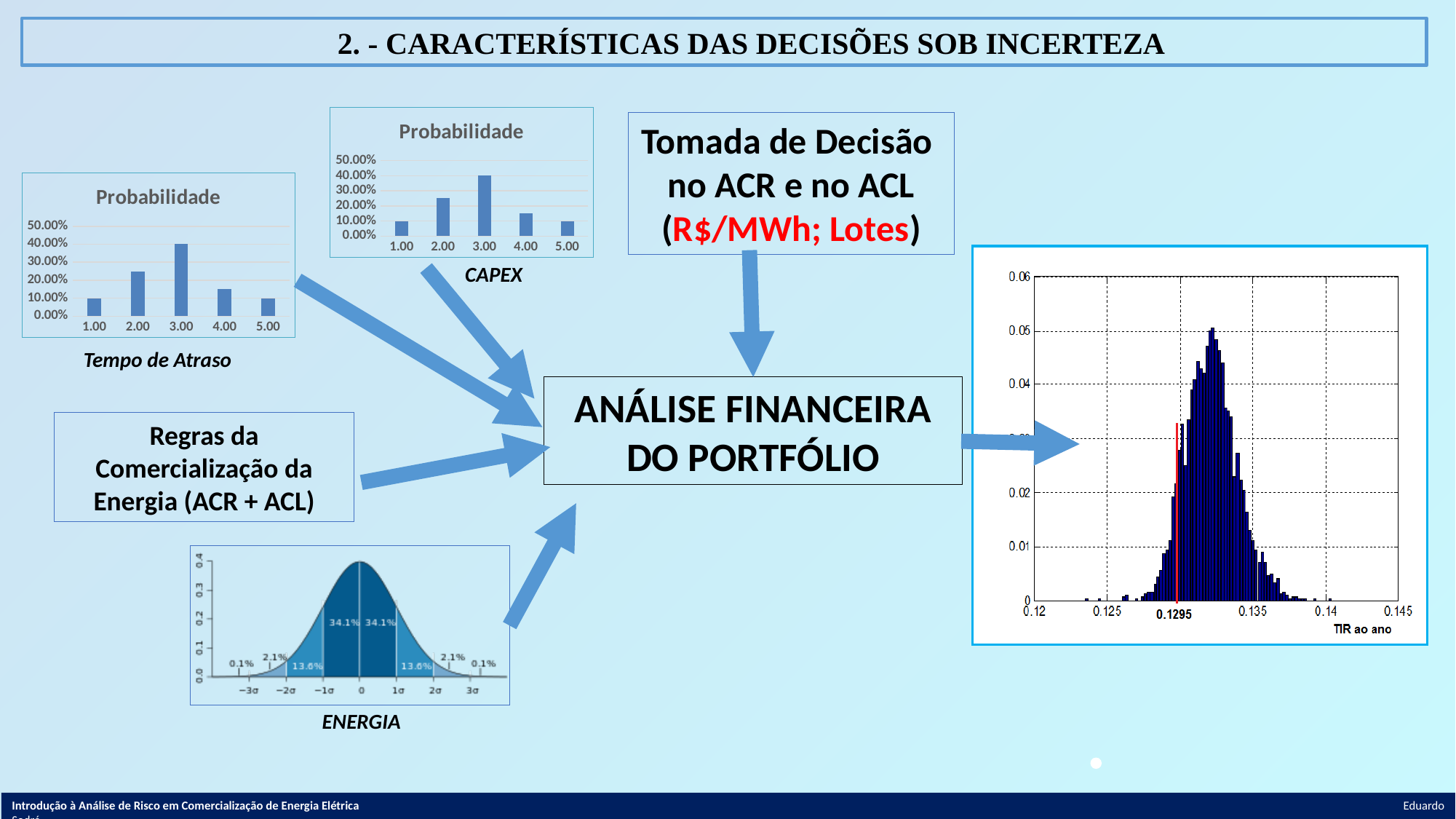
In the ENERGIA normal distribution chart, what percentage is labelled between 1σ and 2σ? 13.6% In the CAPEX Probabilidade chart, which is larger, the value for 2.00 or the value for 4.00? 2.00 In the 'Tempo de Atraso' Probabilidade chart, which category has the highest probability? 3.00 What kind of chart is the 'Tempo de Atraso' Probabilidade chart? bar chart In the CAPEX Probabilidade chart, which category has the highest probability? 3.00 In the CAPEX Probabilidade chart, is the value for 2.00 greater or less than 20.00%? greater In the 'Tempo de Atraso' Probabilidade chart, how many categories are shown on the x axis? 5 In the 'Tempo de Atraso' Probabilidade chart, is the value for 1.00 greater or less than 20.00%? less In the ENERGIA normal distribution chart, what percentage is labelled between 0 and 1σ? 34.1% In the 'Tempo de Atraso' Probabilidade chart, is the value for 3.00 greater or less than 30.00%? greater In the histogram on the right, what value on the x axis is marked by the red vertical line? 0.1295 In the CAPEX Probabilidade chart, what is the highest value shown on the y axis? 50.00%